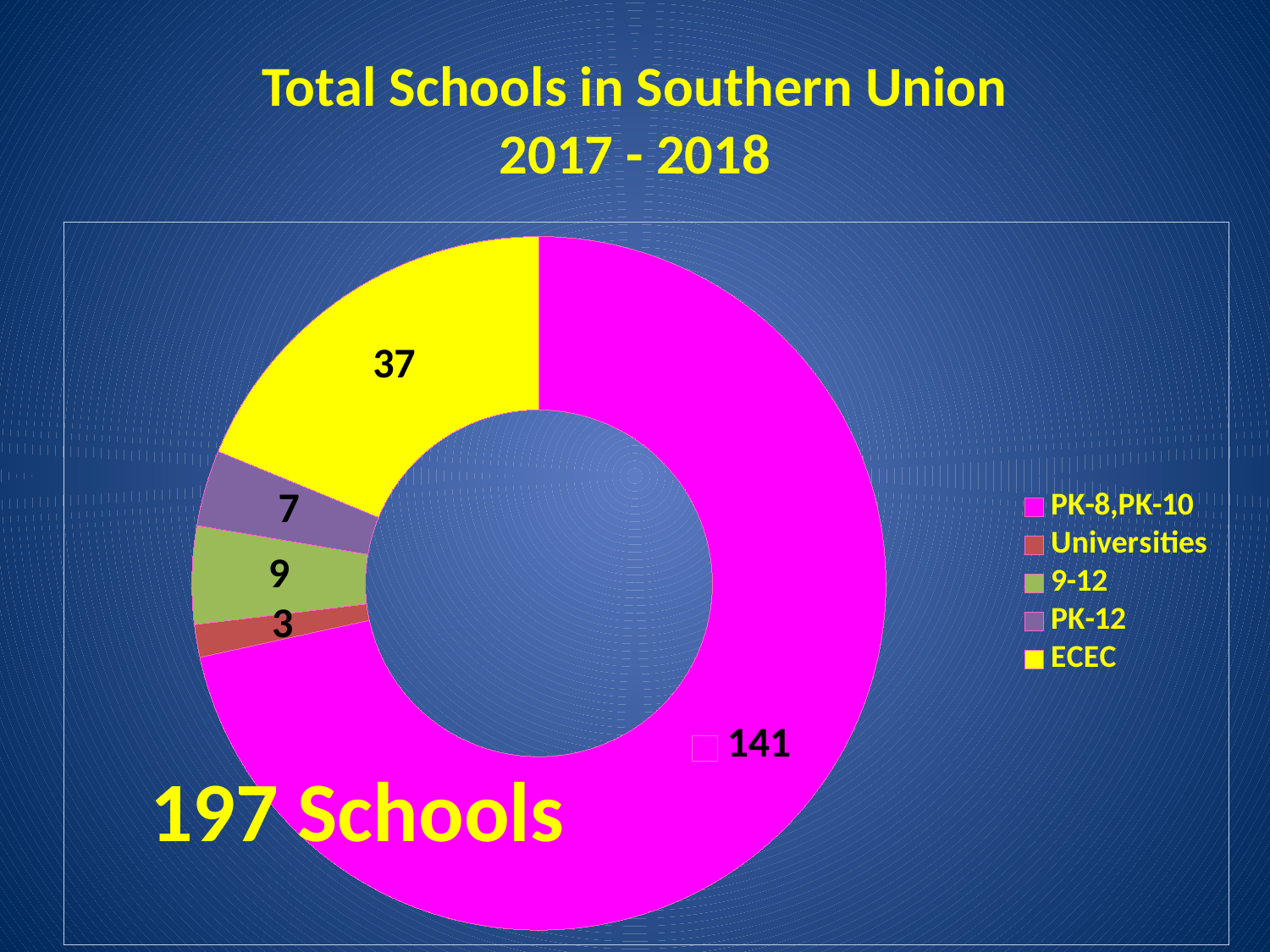
How many schools are in the 9-12 category? 9 Which category has the smallest number of schools? Universities How many schools are in the PK-12 category? 7 Which category has more schools, 9-12 or PK-12? 9-12 How many categories does the legend list? 5 How many schools are in the PK-8,PK-10 category? 141 Which category has the largest number of schools? PK-8,PK-10 How many schools are in the ECEC category? 37 How many Universities are shown in the chart? 3 What kind of chart is shown on the slide? doughnut chart What is the total number of schools stated on the chart? 197 Schools What is the difference between the number of PK-8,PK-10 schools and ECEC schools? 104